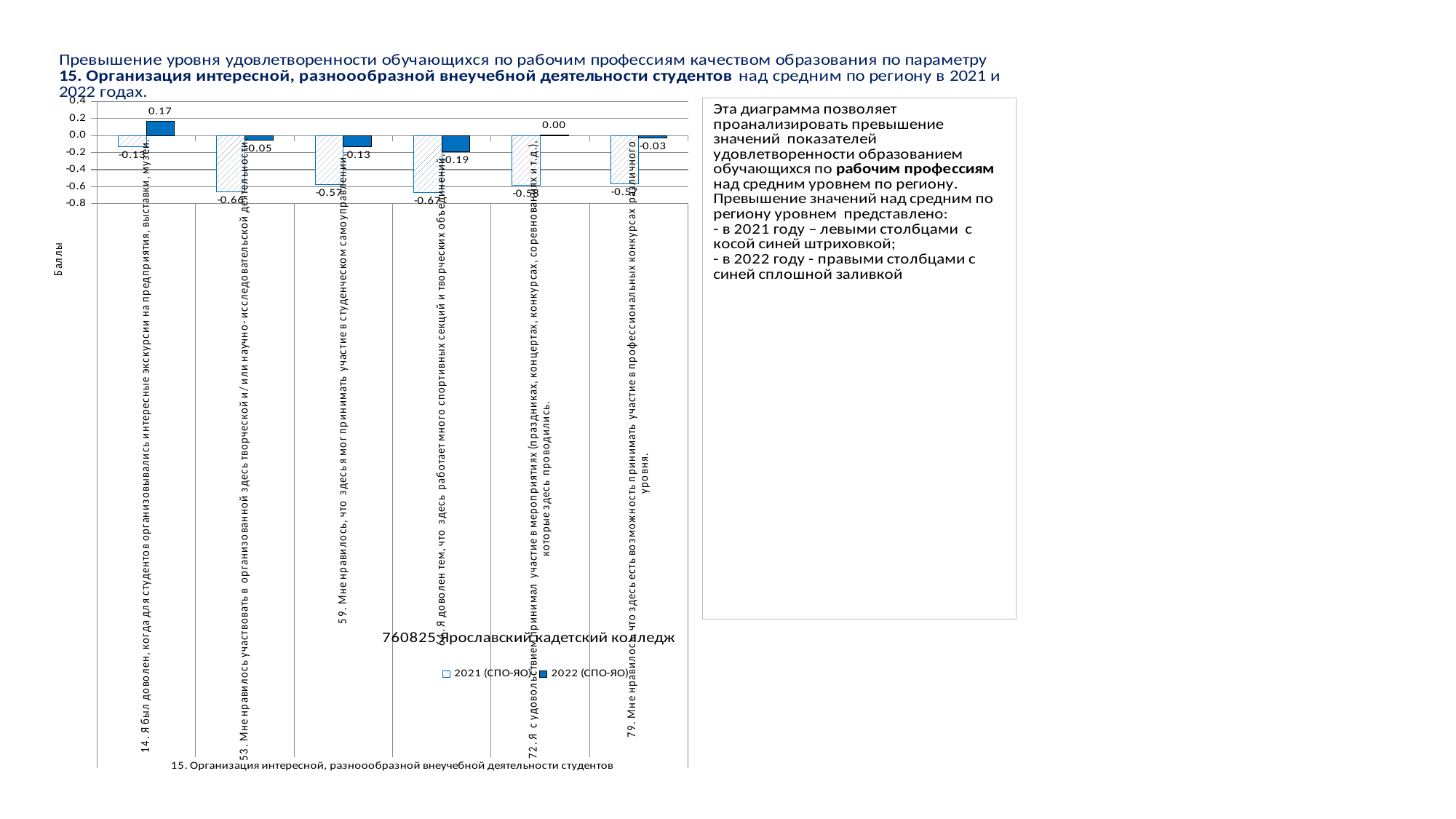
For item 53 (creative and/or research activity), which is larger: the 2021 value or the 2022 value? 2022 How many series does the chart legend list? 2 What kind of chart is shown on the slide? bar chart By how much does the 2022 value for item 14 exceed the 2021 value for the same item? 0.30 What is the 2022 (СПО-ЯО) value for item 14 (excursions to enterprises, exhibitions, museums)? 0.17 What is the 2021 (СПО-ЯО) value for item 14 (excursions to enterprises, exhibitions, museums)? -0.13 Is the 2021 (СПО-ЯО) value for item 72 greater or less than -0.4? less Which item has the highest 2022 (СПО-ЯО) value? 14. Я был доволен, когда для студентов организовывались интересные экскурсии на предприятия, выставки, музеи. Which item has the lowest 2022 (СПО-ЯО) value? 64. Я доволен тем, что здесь работает много спортивных секций и творческих объединений. What is the 2022 (СПО-ЯО) value for item 72 (participation in events such as holidays, concerts, competitions)? 0.00 How many categories (survey items) are plotted on the chart? 6